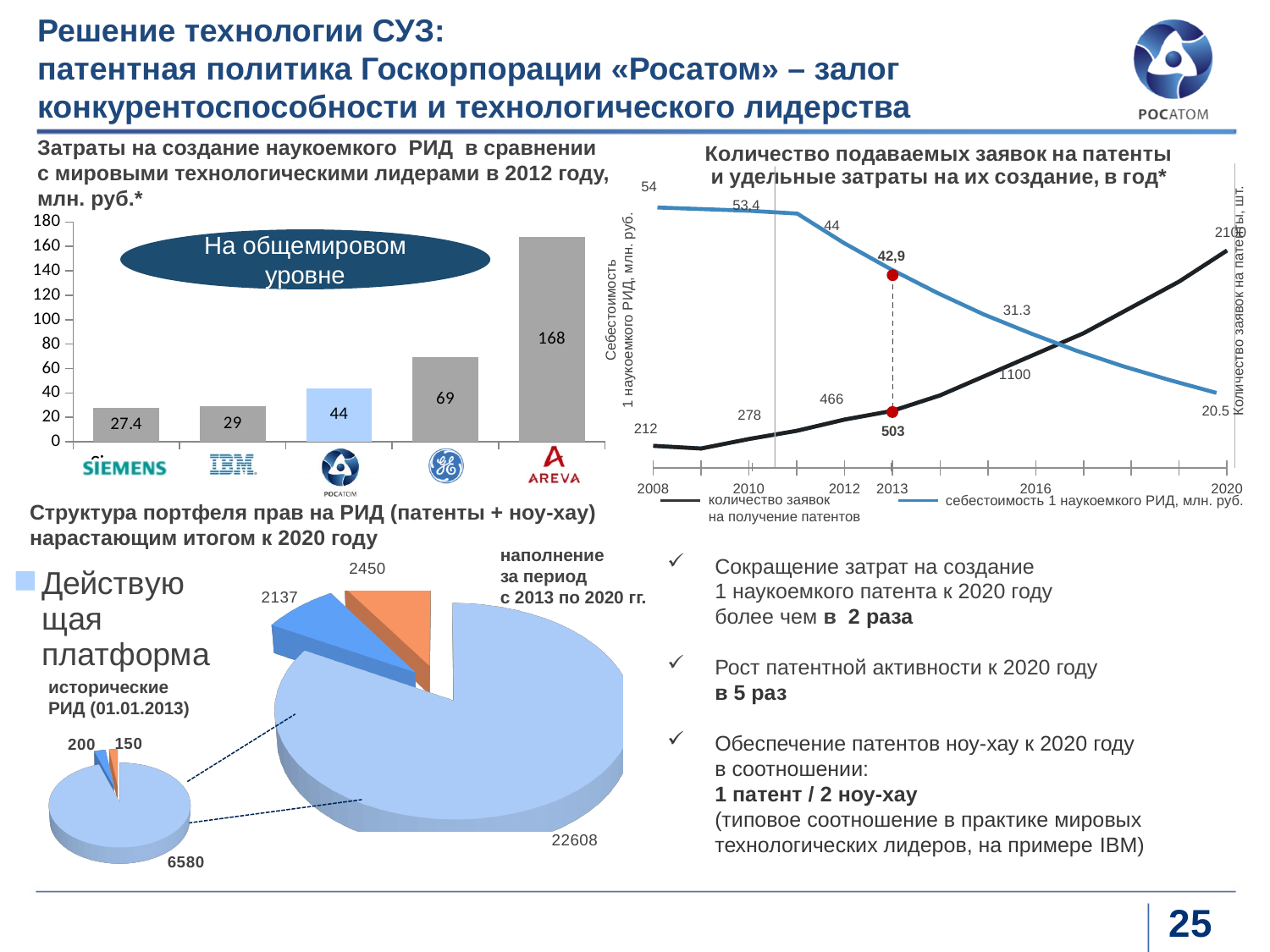
In the line chart on the top right, what is the cost of one science-intensive RID (себестоимость) in 2013? 42,9 How many series does the legend of the line chart on the top right list? 2 In the line chart on the top right, does the cost of one science-intensive RID rise or fall from 2008 to 2020? fall In the bar chart on the top left, which company has the highest value? AREVA In the bar chart on the top left, which company has the lowest value? Siemens In the bar chart on the top left, what is the difference between the values for AREVA and GE? 99 How many companies are shown in the bar chart on the top left? 5 In the bar chart on the top left, what is the value for Siemens? 27.4 In the line chart on the top right, what is the number of patent applications in 2013? 503 What kind of chart is the chart on the top left? bar chart In the bar chart on the top left (costs of creating science-intensive RID in 2012), what is the value for AREVA? 168 In the bar chart on the top left, which is larger: the value for GE or the value for Rosatom? GE